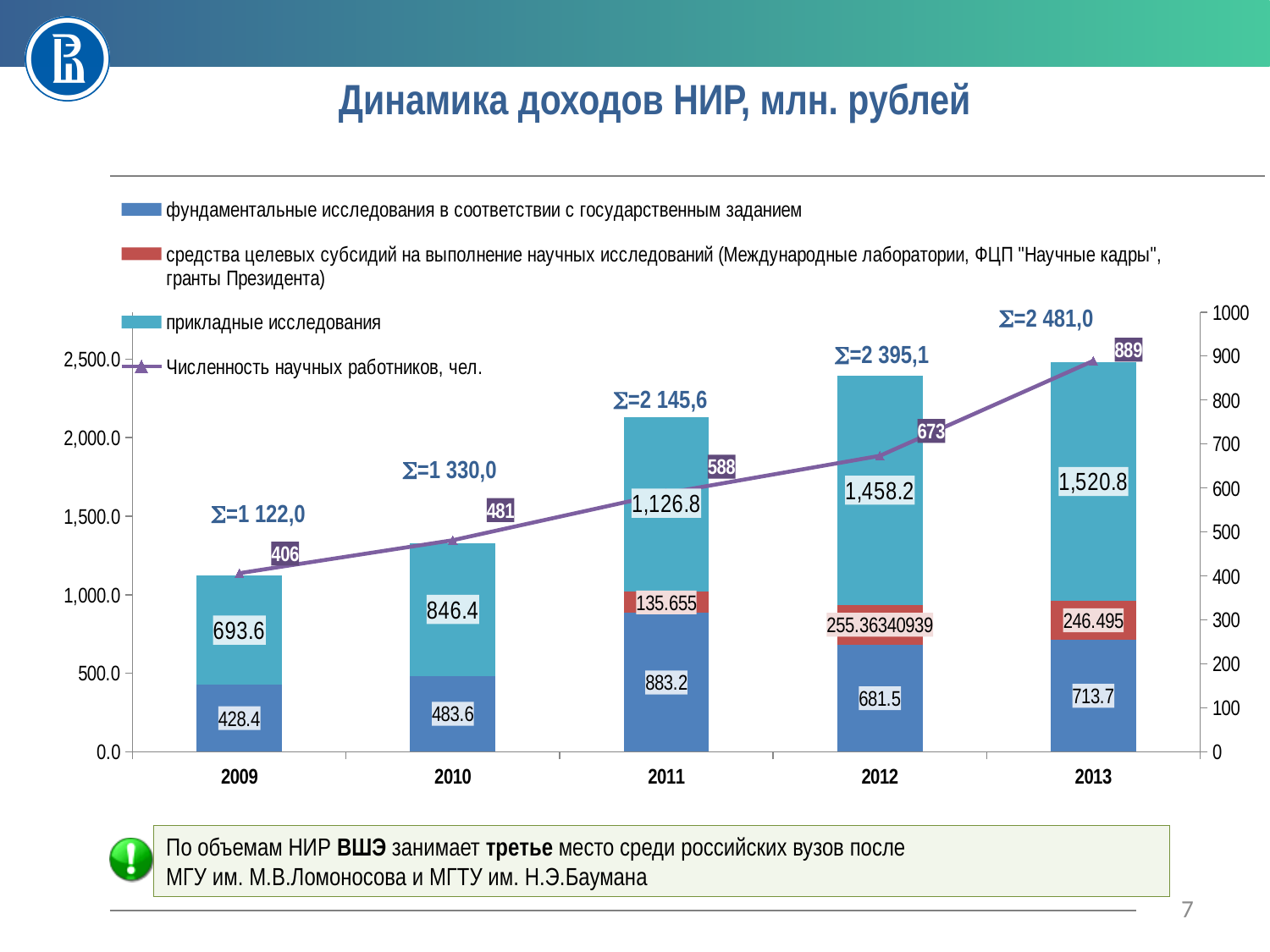
What is the value of прикладные исследования in 2013? 1,520.8 What is the difference between the прикладные исследования values for 2012 and 2011? 331.4 Which is larger: фундаментальные исследования in 2011 or in 2013? 2011 What is the value of фундаментальные исследования в соответствии с государственным заданием in 2009? 428.4 What kind of chart is shown on the slide? Stacked bar chart with a line How many years are shown on the x axis? 5 Which year has the lowest Численность научных работников, чел.? 2009 What is the Численность научных работников, чел. value for 2011? 588 How many series does the legend list? 4 What is the total shown for the 2012 stacked bar? Σ=2 395,1 What is the value of средства целевых субсидий на выполнение научных исследований in 2013? 246.495 Which year has the highest value for прикладные исследования? 2013